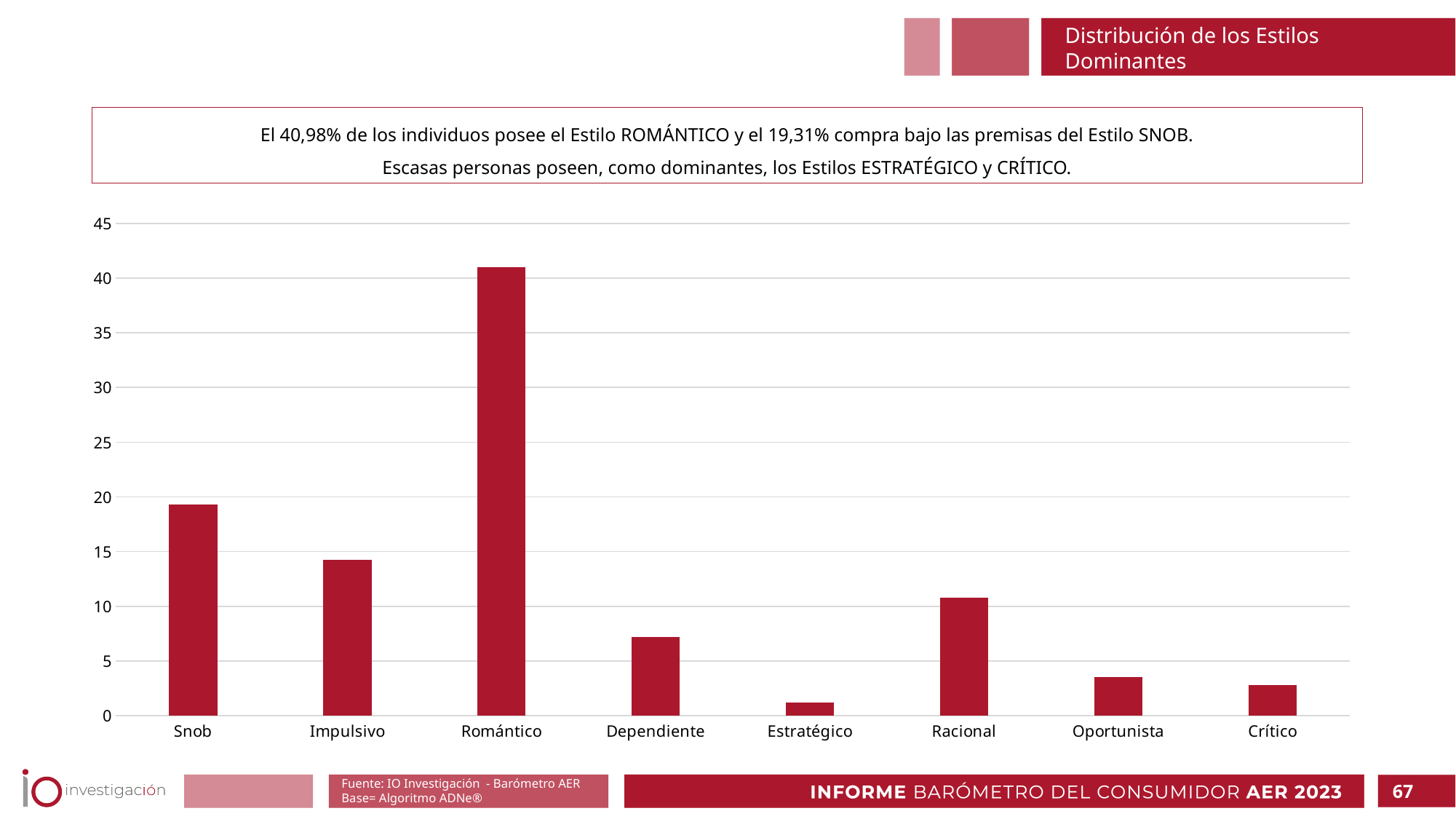
Which style has the highest bar in the chart? Romántico Which style has the lowest bar in the chart? Estratégico What is the title of the chart shown in the header of the slide? Distribución de los Estilos Dominantes Which is larger, the value for Snob or the value for Impulsivo? Snob According to the text on the slide, what percentage of individuals buy under the Snob style? 19,31% Is the value for Oportunista greater or less than 5? less Which is larger, the value for Racional or the value for Dependiente? Racional Is the value for Impulsivo greater or less than 10? greater What is the difference between the percentages given for Romántico and Snob? 21,67% According to the text on the slide, what percentage of individuals have the Romántico style? 40,98% How many categories (styles) are shown on the x axis of the chart? 8 What kind of chart is shown on the slide? bar chart